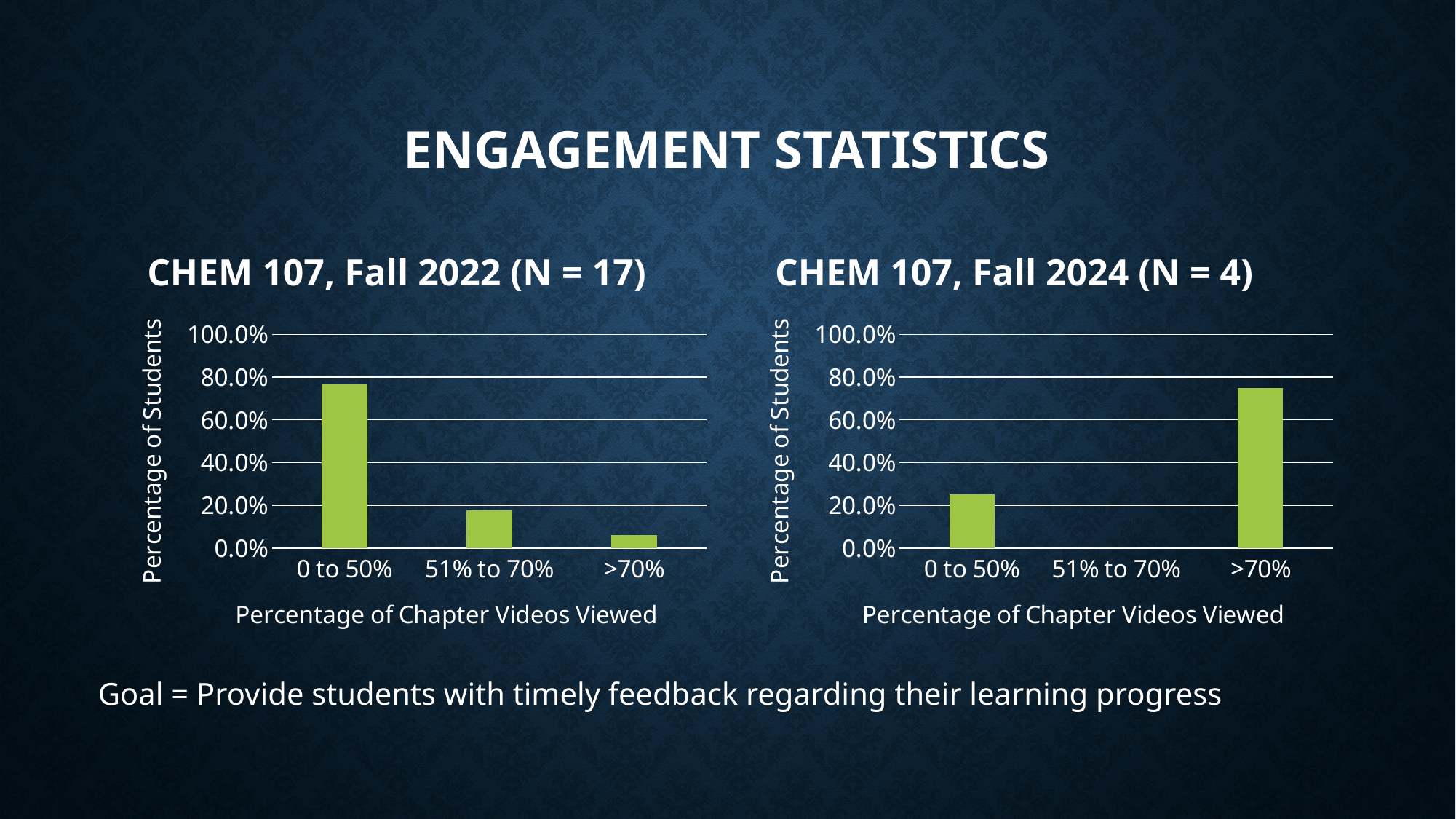
In the CHEM 107, Fall 2022 (N = 17) chart, do the values rise or fall from left to right along the x axis? fall In the CHEM 107, Fall 2024 (N = 4) chart, is the value for 0 to 50% greater or less than 40.0%? less In the CHEM 107, Fall 2022 (N = 17) chart, which category has the lowest percentage of students? >70% What is the x-axis title of the CHEM 107, Fall 2022 (N = 17) chart? Percentage of Chapter Videos Viewed In the CHEM 107, Fall 2024 (N = 4) chart, is the value for >70% greater or less than 60.0%? greater What kind of chart is the CHEM 107, Fall 2022 (N = 17) chart? bar chart In the CHEM 107, Fall 2022 (N = 17) chart, is the value for 0 to 50% greater or less than 60.0%? greater In the CHEM 107, Fall 2024 (N = 4) chart, which category has the highest percentage of students? >70% In the CHEM 107, Fall 2022 (N = 17) chart, which category has the highest percentage of students? 0 to 50% In the CHEM 107, Fall 2024 (N = 4) chart, which is larger: the value for 0 to 50% or the value for >70%? >70% How many categories are shown on the x axis of the CHEM 107, Fall 2024 (N = 4) chart? 3